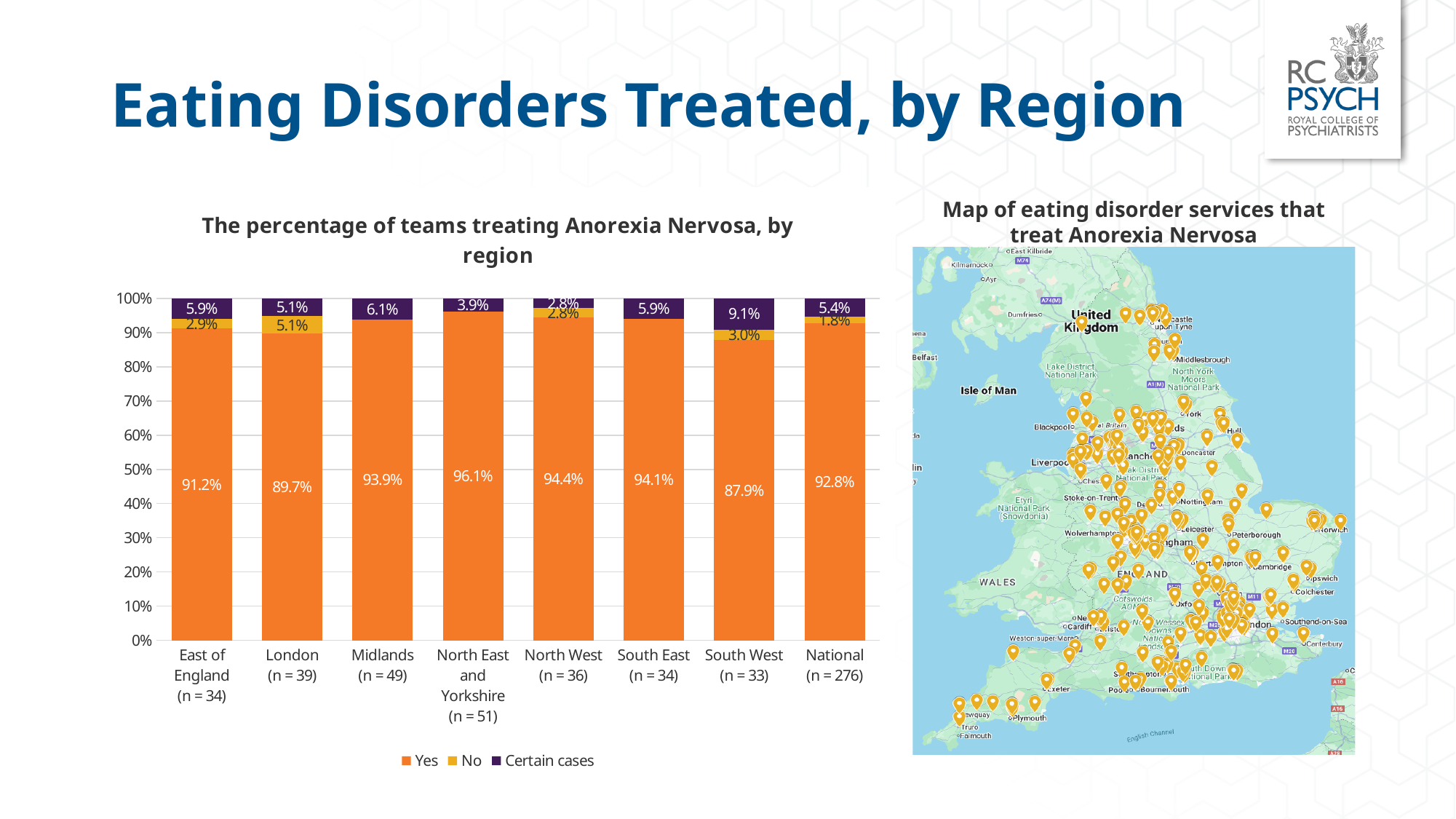
Which region has the lowest Yes percentage? South West How many series does the legend list? 3 What kind of chart is used to show the percentage of teams treating Anorexia Nervosa? Stacked bar chart What is the sample size (n) shown for the National bar? 276 How many regions (bars) are shown in the chart? 8 What is the difference between the Yes percentage for North East and Yorkshire and the Yes percentage for South West? 8.2% Which region has the highest Yes percentage? North East and Yorkshire Which has a larger Certain cases percentage, South West or Midlands? South West What is the No percentage for the National bar? 1.8% What is the Certain cases percentage for South West? 9.1% What percentage of teams in London answered Yes to treating Anorexia Nervosa? 89.7% Which legend entry is shown in orange? Yes